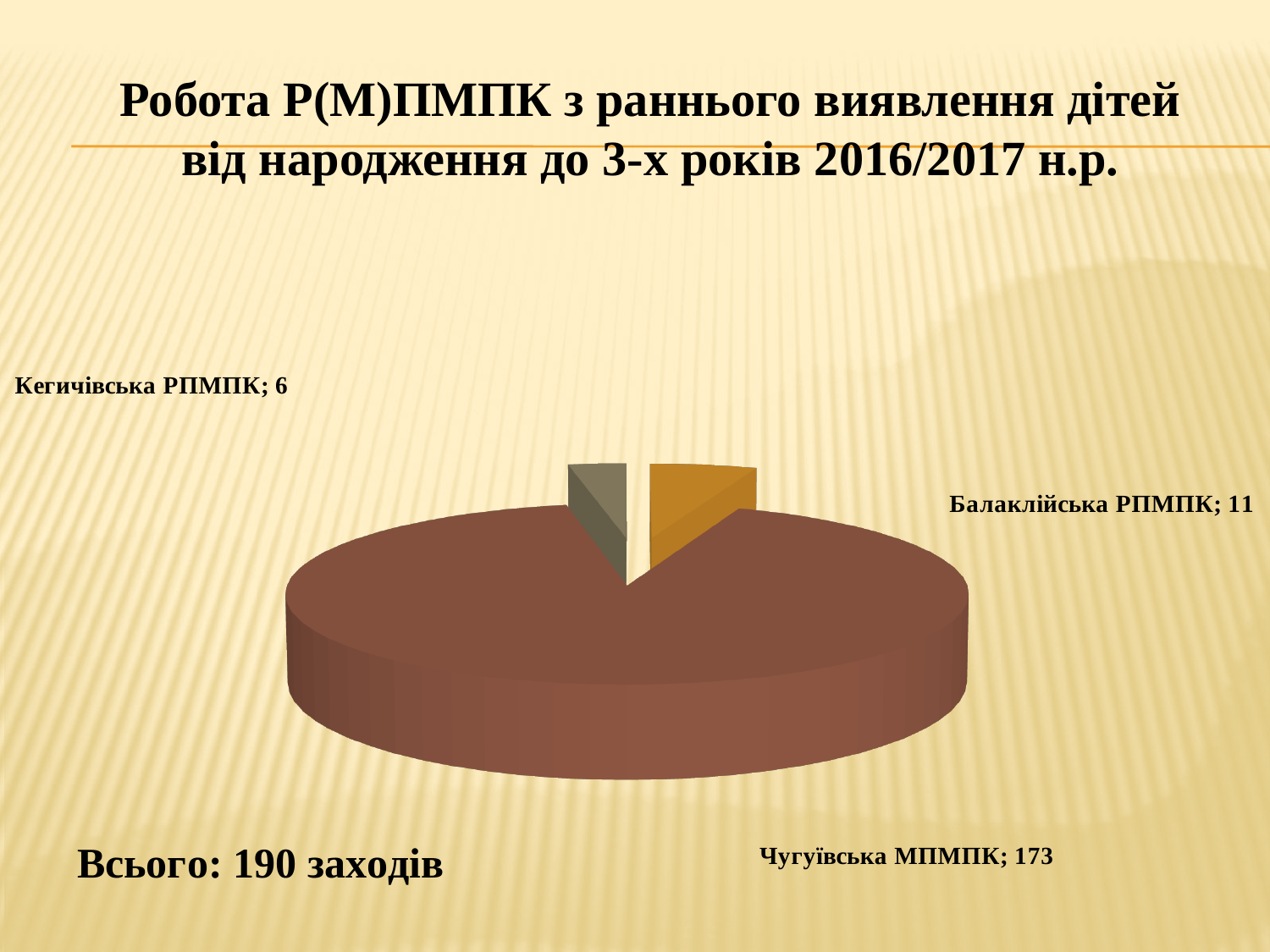
How many slices does the pie chart have? 3 Which category has the largest slice of the pie? Чугуївська МПМПК What total number of events (заходів) is stated on the slide? 190 What is the difference between the values for Балаклійська РПМПК and Кегичівська РПМПК? 5 Which category has the smallest slice of the pie? Кегичівська РПМПК What is the value for Балаклійська РПМПК? 11 What kind of chart is shown on the slide? pie chart Which is larger, the value for Балаклійська РПМПК or the value for Кегичівська РПМПК? Балаклійська РПМПК What is the value for Чугуївська МПМПК? 173 What is the difference between the values for Чугуївська МПМПК and Балаклійська РПМПК? 162 What is the value for Кегичівська РПМПК? 6 What colour is the slice for Чугуївська МПМПК? brown